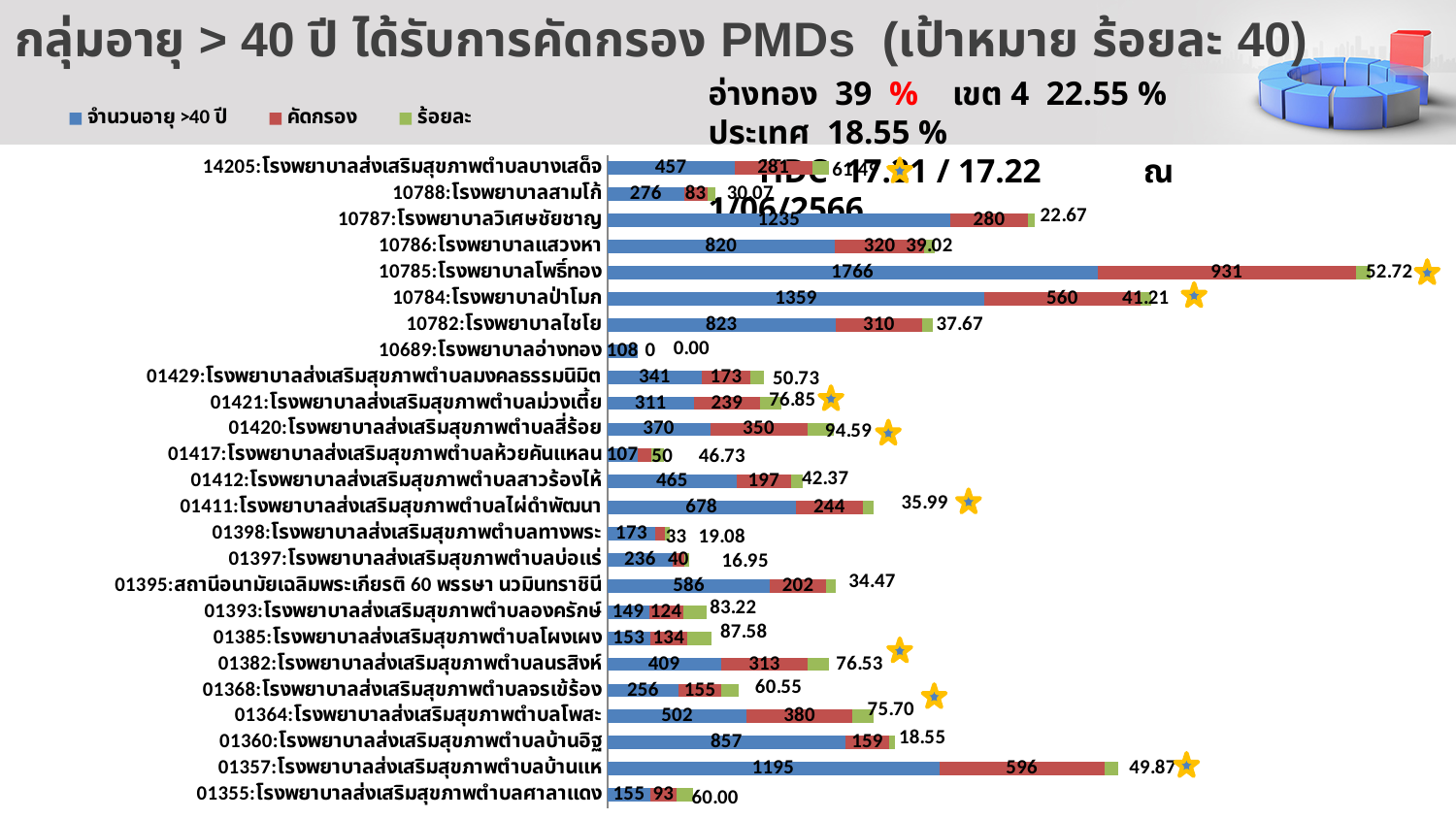
What type of chart is shown on the slide? bar chart What is the difference between the จำนวนอายุ >40 ปี value and the คัดกรอง value for 01357:โรงพยาบาลส่งเสริมสุขภาพตำบลบ้านแห? 599 What is the คัดกรอง value for 10784:โรงพยาบาลป่าโมก? 560 What is the จำนวนอายุ >40 ปี value for 10785:โรงพยาบาลโพธิ์ทอง? 1766 What is the ร้อยละ value for 01420:โรงพยาบาลส่งเสริมสุขภาพตำบลสี่ร้อย? 94.59 How many hospital categories are plotted in the chart? 25 Which has a larger คัดกรอง value: 10786:โรงพยาบาลแสวงหา or 10782:โรงพยาบาลไชโย? 10786:โรงพยาบาลแสวงหา Which series in the legend is shown in red? คัดกรอง What is the ร้อยละ value for 01360:โรงพยาบาลส่งเสริมสุขภาพตำบลบ้านอิฐ? 18.55 Which hospital has the lowest ร้อยละ value? 10689:โรงพยาบาลอ่างทอง Which hospital has the highest จำนวนอายุ >40 ปี value? 10785:โรงพยาบาลโพธิ์ทอง How many series does the legend list? 3